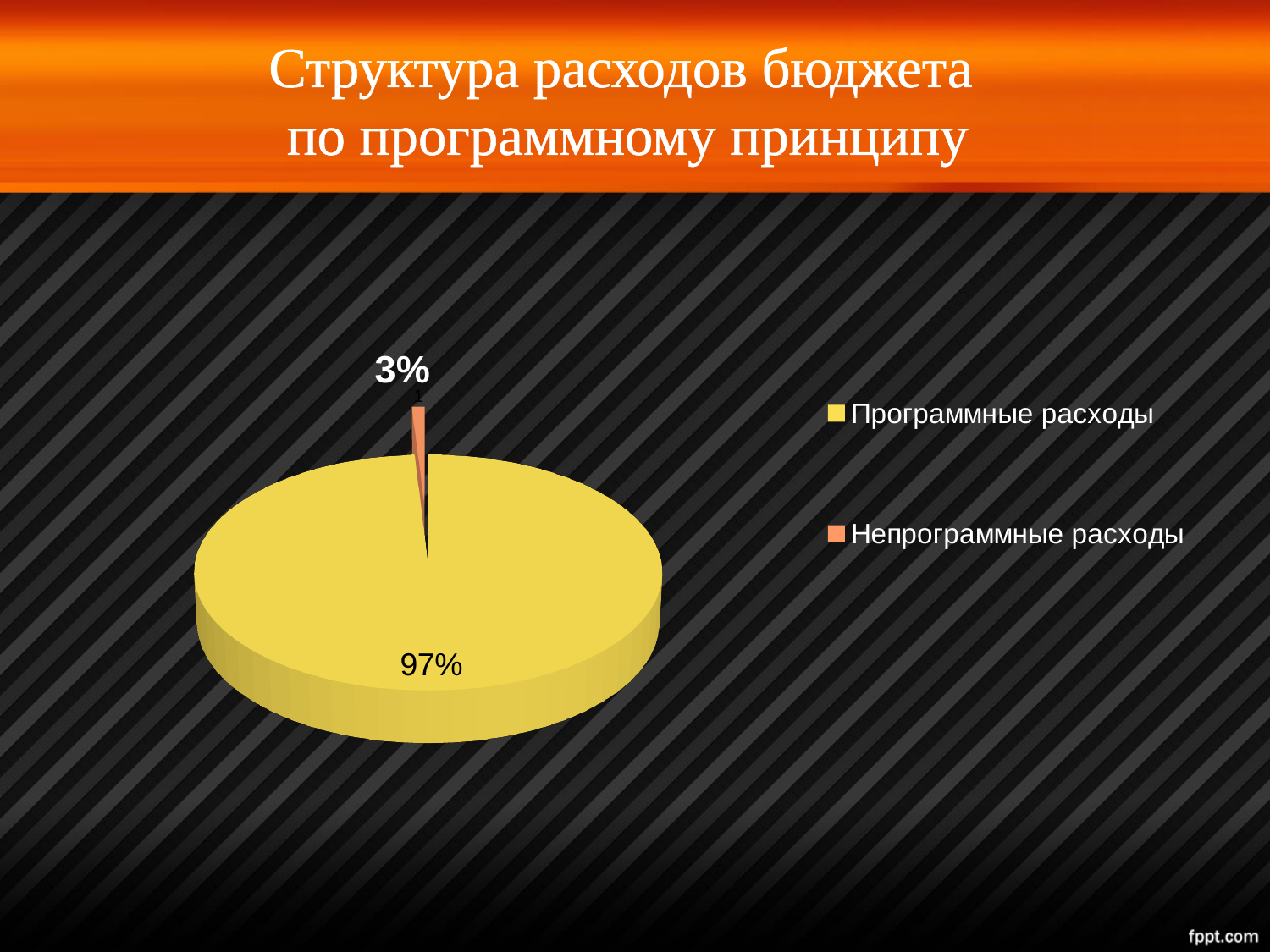
What share of the pie does Непрограммные расходы take? 3% How many entries does the legend list? 2 Which category has the largest slice of the pie? Программные расходы Which category has the smallest slice of the pie? Непрограммные расходы What is the title of the slide containing the chart? Структура расходов бюджета по программному принципу What colour is the slice for Непрограммные расходы? orange How many slices does the pie chart have? 2 Which is larger, Программные расходы or Непрограммные расходы? Программные расходы What share of the pie does Программные расходы take? 97% What is the difference in percentage points between Программные расходы and Непрограммные расходы? 94 What kind of chart is shown on the slide? pie chart